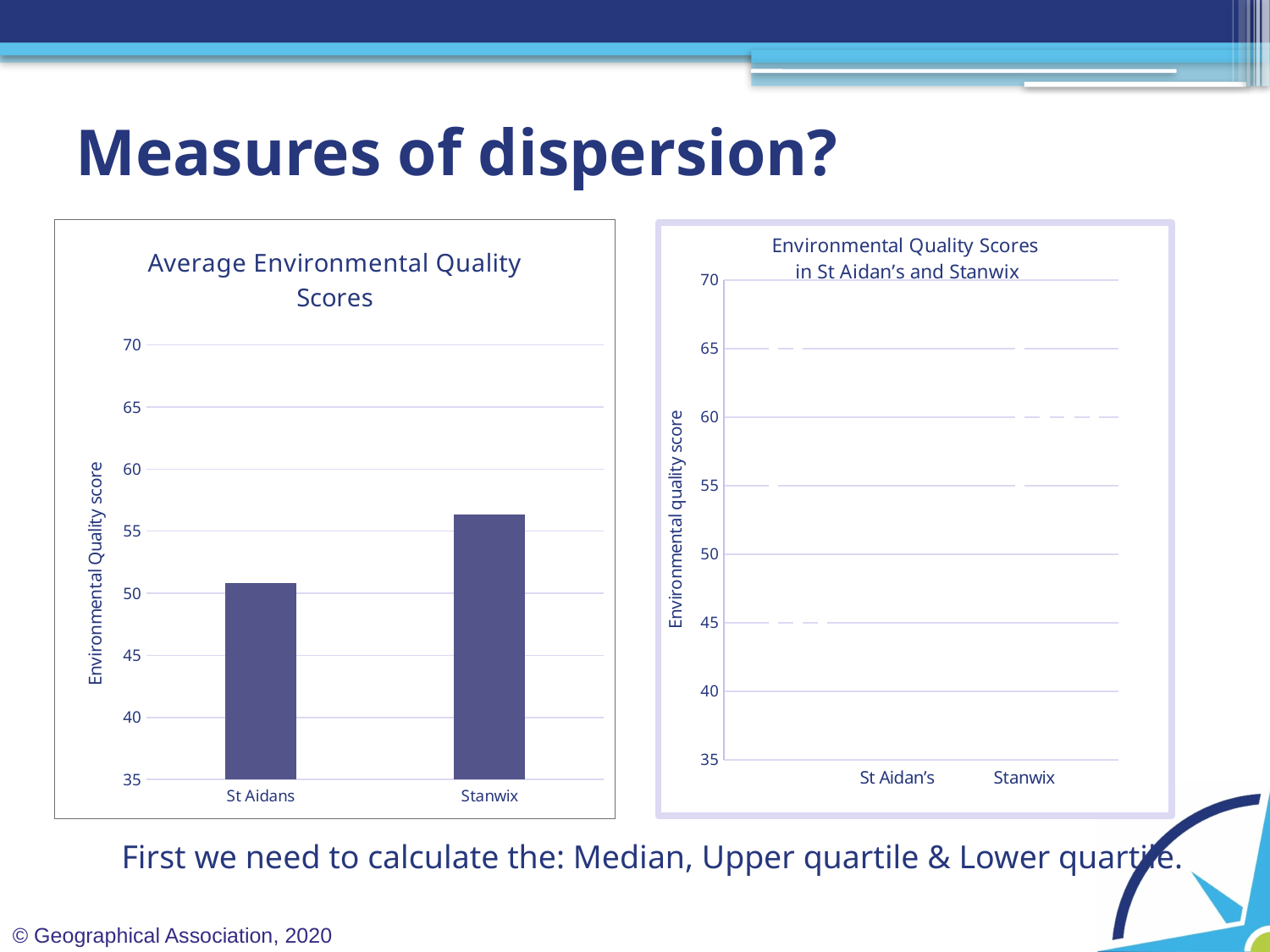
What kind of chart is the left chart titled 'Average Environmental Quality Scores'? bar chart In the left chart 'Average Environmental Quality Scores', is the value for St Aidans greater or less than 55? less In the left chart 'Average Environmental Quality Scores', which category has the highest average score? Stanwix In the left chart 'Average Environmental Quality Scores', is the value for Stanwix greater or less than 60? less In the left chart 'Average Environmental Quality Scores', is the value for Stanwix greater or less than 55? greater In the right chart 'Environmental Quality Scores in St Aidan's and Stanwix', how many categories are labelled on the x axis? 2 In the left chart 'Average Environmental Quality Scores', which category has the lowest average score? St Aidans In the left chart 'Average Environmental Quality Scores', how many categories are shown on the x axis? 2 What is the title of the right chart on the slide? Environmental Quality Scores in St Aidan's and Stanwix In the left chart 'Average Environmental Quality Scores', which is larger, the value for St Aidans or the value for Stanwix? Stanwix In the left chart 'Average Environmental Quality Scores', what is the label on the y axis? Environmental Quality score